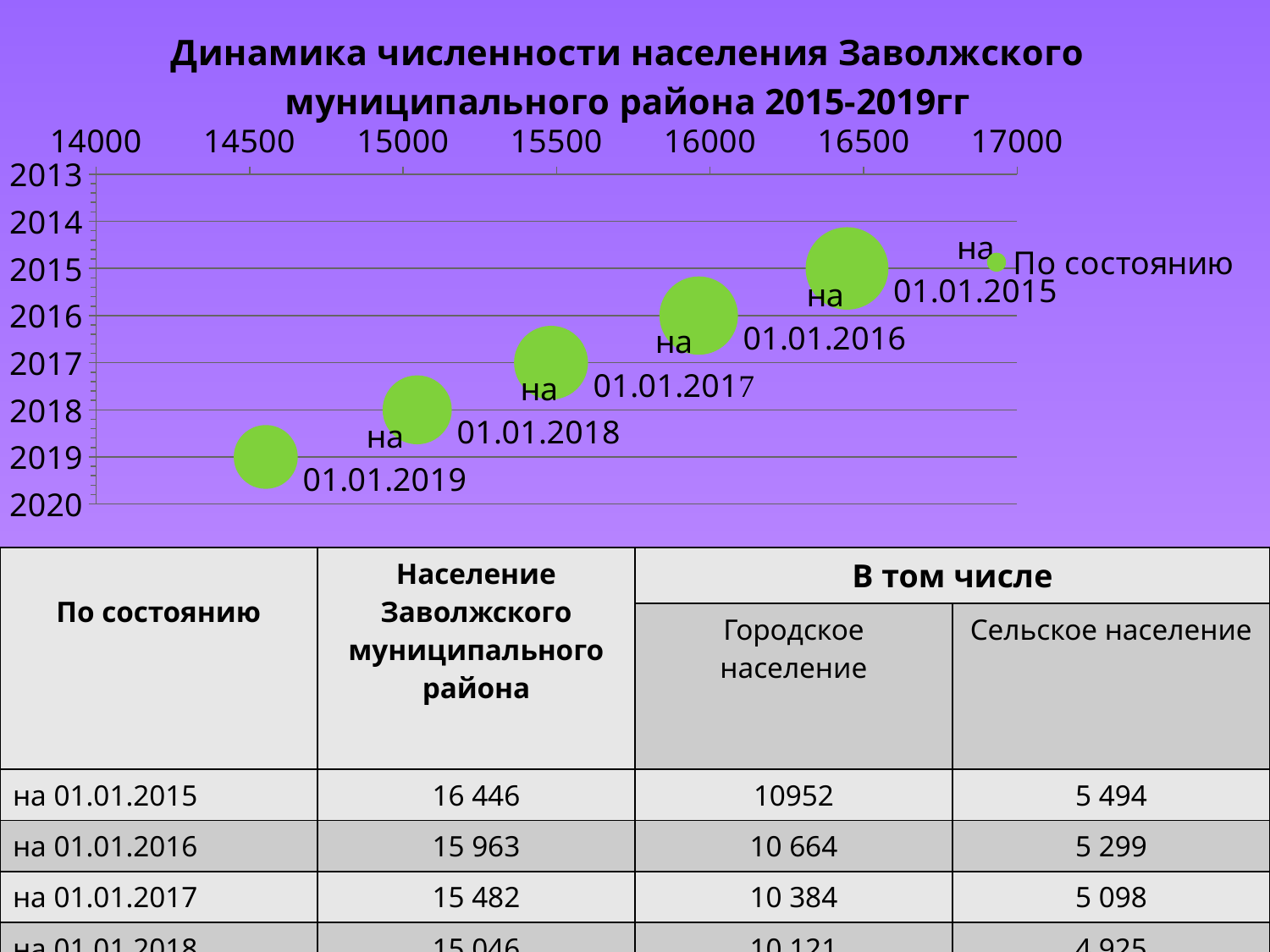
What kind of chart is shown on the slide? bubble chart What is the legend entry shown on the chart? По состоянию How many bubbles (data points) are plotted on the chart? 5 Which date has the highest population value on the chart? на 01.01.2015 Is the value for на 01.01.2015 greater or less than 16000? greater Is the value for на 01.01.2019 greater or less than 15000? less Is the value for на 01.01.2016 greater or less than 15500? greater Which is larger, the population on 01.01.2016 or on 01.01.2018? 01.01.2016 Does the population value rise or fall from 01.01.2015 to 01.01.2019 on the chart? fall Which date has the lowest population value on the chart? на 01.01.2019 According to the table under the chart, what is the population of the Zavolzhsky municipal district on 01.01.2015? 16 446